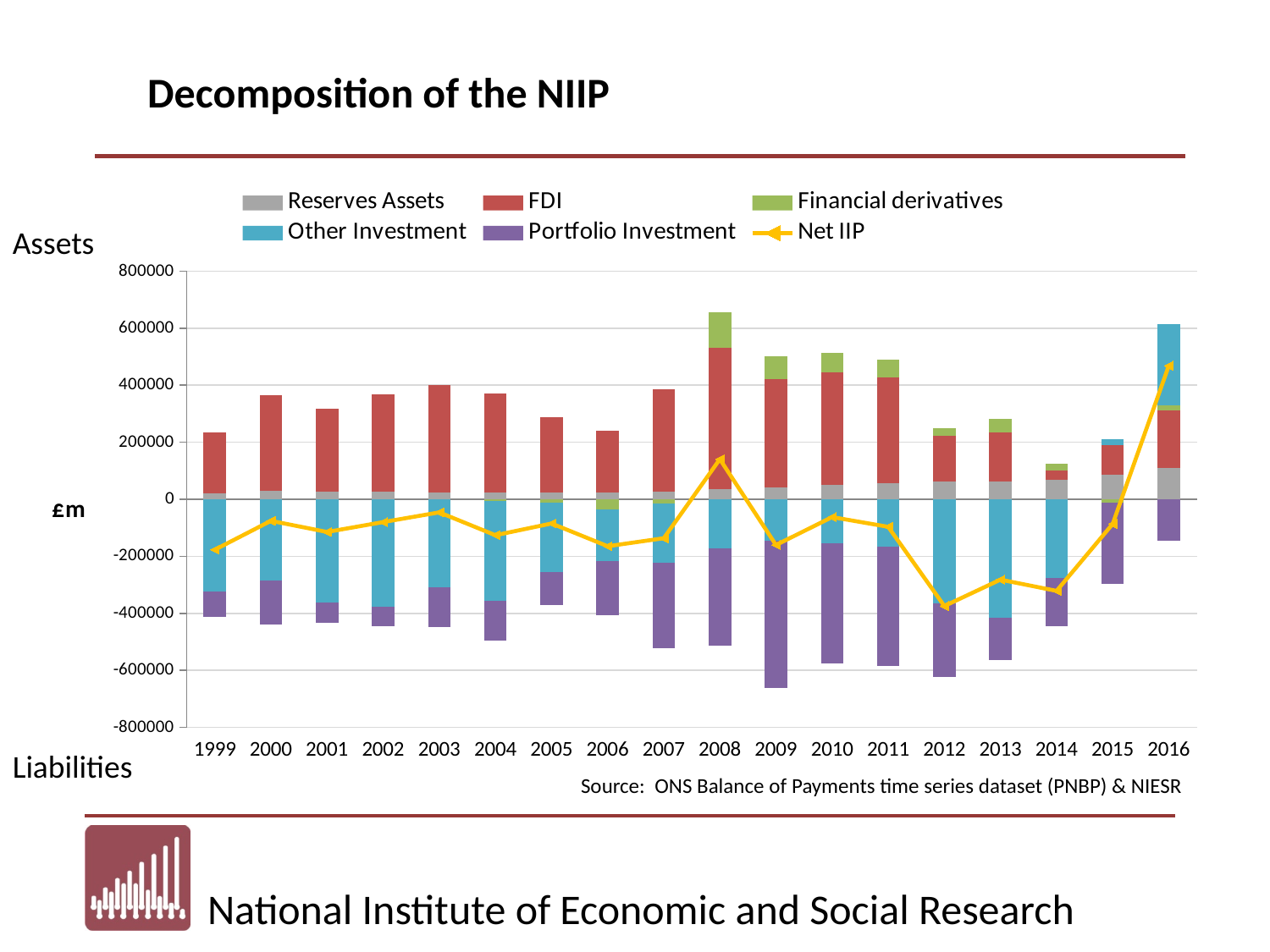
Which series is plotted as a line rather than as bars? Net IIP Does the Net IIP line rise or fall from 2012 to 2016? rise How many years are shown on the x axis of the chart? 18 How many series does the legend list? 6 Is the Net IIP value for 2008 greater or less than 0? greater What kind of chart is shown on the slide? Stacked bar chart with a line Which year has the larger Net IIP value, 2007 or 2008? 2008 Is the Net IIP value for 2016 greater or less than 400000? greater What is the title of the chart? Decomposition of the NIIP Is the Net IIP value for 2012 greater or less than -200000? less In which year does the Net IIP line reach its lowest value? 2012 In which year does the Net IIP line reach its highest value? 2016